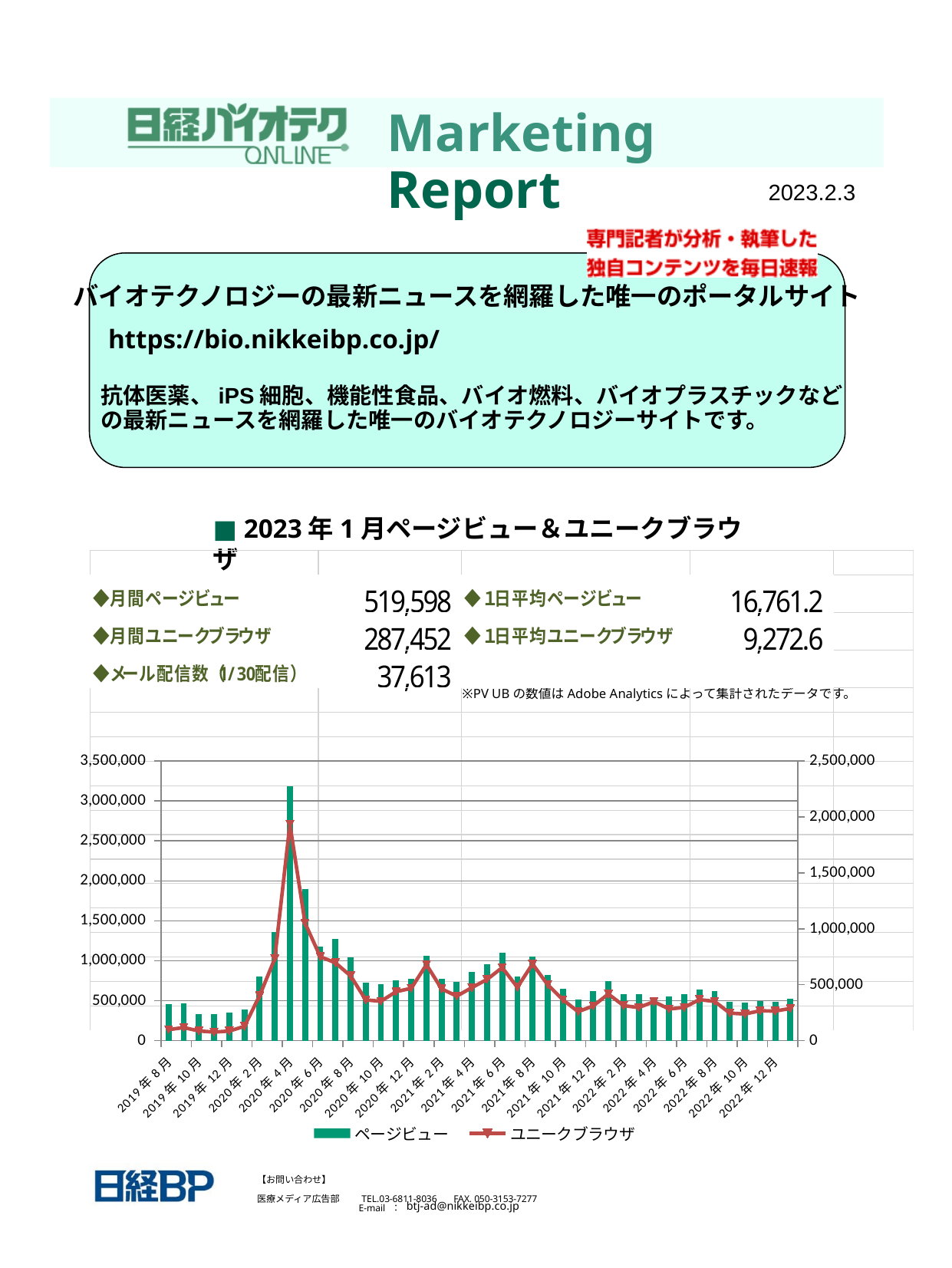
Is the unique browser value for 2020年4月 greater or less than 1,500,000 on the right axis? greater How many series does the chart legend list? 2 Is the page view value for 2022年12月 greater or less than 1,000,000? less In which month do the page views (ページビュー) reach their highest value? 2020年4月 In which month does the unique browser (ユニークブラウザ) line reach its peak? 2020年4月 Is the page view value for 2020年6月 greater or less than 1,000,000? greater What kind of chart is shown on the slide? A combined bar and line chart Which month has higher page views, 2020年4月 or 2020年6月? 2020年4月 Do page views rise or fall from 2020年4月 to 2020年8月? fall What are the two series named in the chart legend? ページビュー and ユニークブラウザ Which series is drawn as bars in the chart? ページビュー